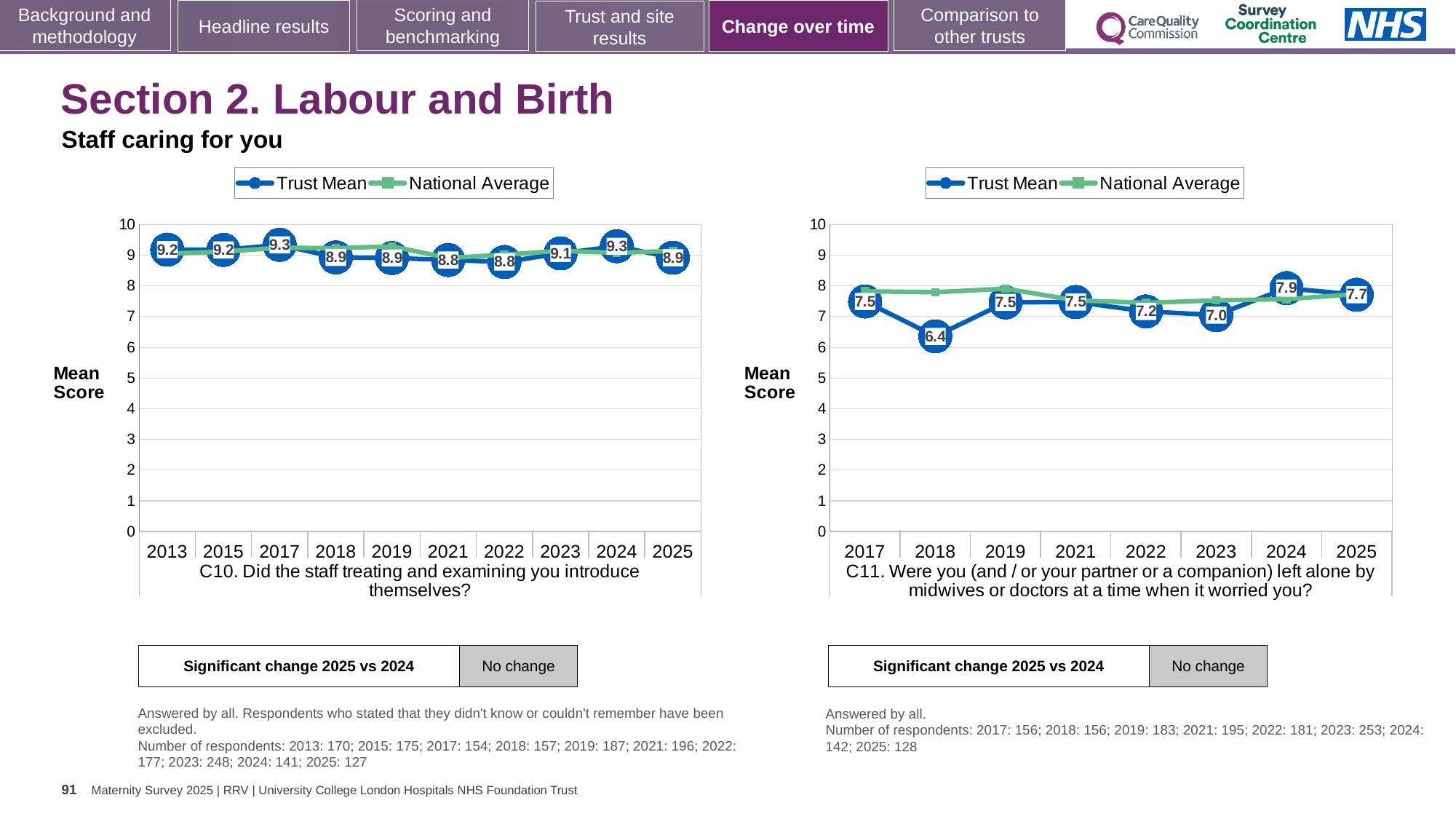
In the C11 chart, what is the difference between the Trust Mean in 2024 and in 2025? 0.2 In the C11 chart, is the Trust Mean for 2023 greater or less than the Trust Mean for 2024? less In the C11 chart, what is the Trust Mean for 2018? 6.4 In the C10 chart, what is the Trust Mean for 2025? 8.9 In the C10 chart, what is the difference between the Trust Mean in 2024 and in 2025? 0.4 In the C10 chart, what is the Trust Mean for 2017? 9.3 In the C10 chart, how many years are plotted on the x axis? 10 How many series does the legend of the C11 chart list? 2 In the C11 chart, which year has the highest Trust Mean? 2024 What type of chart is the C10 chart? Line chart In the C10 chart, which year has the lowest Trust Mean? 2021 and 2022 (8.8) In the C11 chart, which year has the lowest Trust Mean? 2018